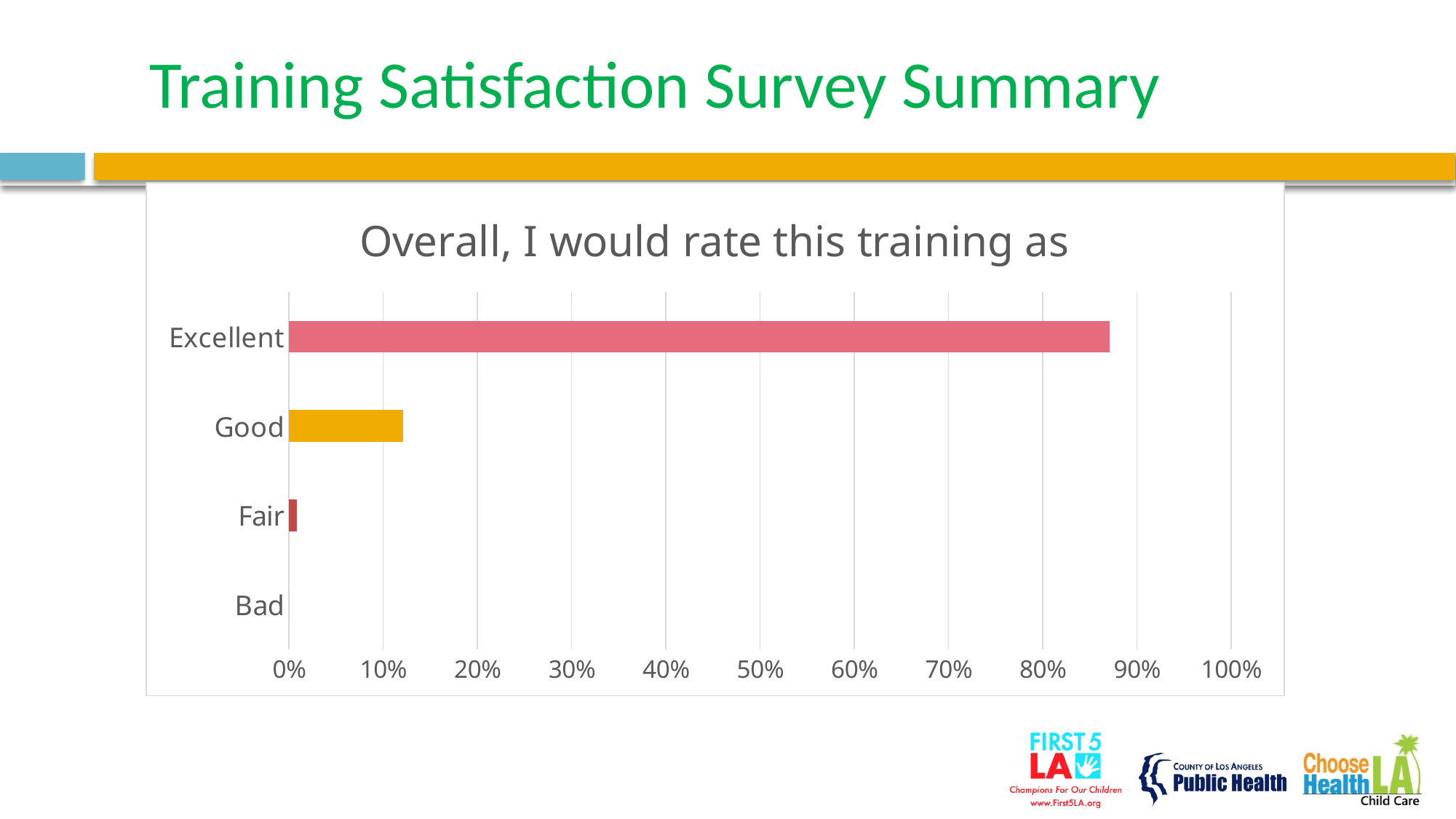
What kind of chart is shown on the slide? bar chart Which has a larger value, Good or Fair? Good Which has a larger value, Excellent or Good? Excellent Which rating category has the highest value? Excellent Which rating category has the lowest value? Bad Is the value for Fair greater or less than 10%? less Is the value for Good greater or less than 10%? greater Is the value for Good greater or less than 20%? less What is the title of the chart? Overall, I would rate this training as How many rating categories are shown on the chart? 4